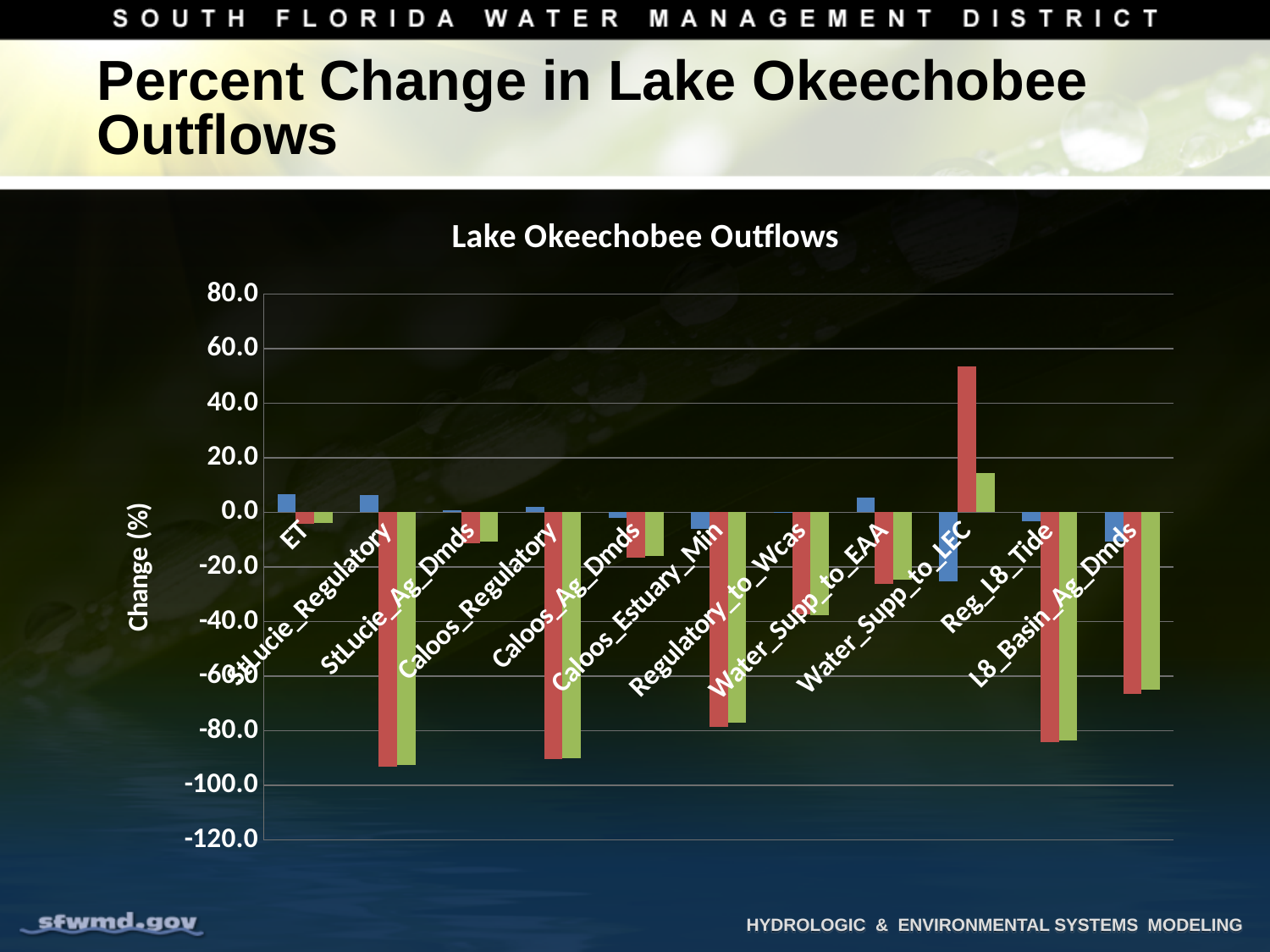
Is the value of the red bar for Reg_L8_Tide greater or less than -80.0? less How many categories are shown along the x axis of the chart? 11 What is the title of the chart? Lake Okeechobee Outflows Is the value of the red bar for Water_Supp_to_LEC greater or less than 40.0? greater Is the value of the blue bar for Water_Supp_to_LEC greater or less than -20.0? less What is the label on the vertical axis of the chart? Change (%) Which category has the highest bar in the chart? Water_Supp_to_LEC How many bars are plotted for each category in the chart? 3 What type of chart is shown on the slide? bar chart Which is larger, the red bar for StLucie_Regulatory or the red bar for Caloos_Ag_Dmds? Caloos_Ag_Dmds